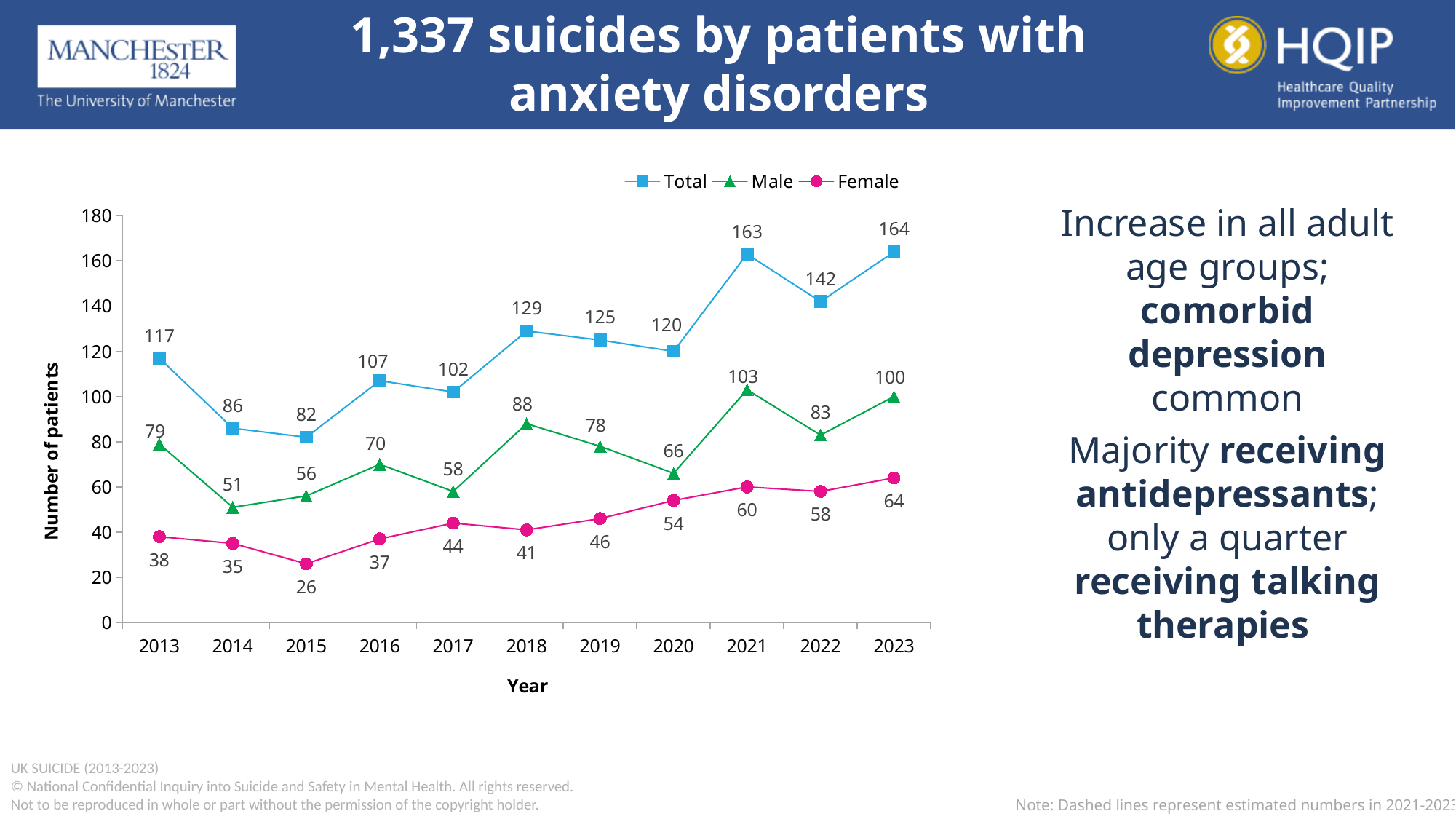
In which year is the Total series highest? 2023 Which is larger, the Male value for 2013 or the Male value for 2014? 2013 What is the Male value for 2018? 88 Is the Total value for 2020 greater or less than 100? greater What kind of chart is shown on the slide? line chart How many series does the legend list? 3 How many years are shown on the x axis? 11 What is the difference between the Total values for 2021 and 2022? 21 What is the Total value for 2021? 163 What is the Female value for 2015? 26 In which year is the Female series lowest? 2015 What is the label of the y axis? Number of patients